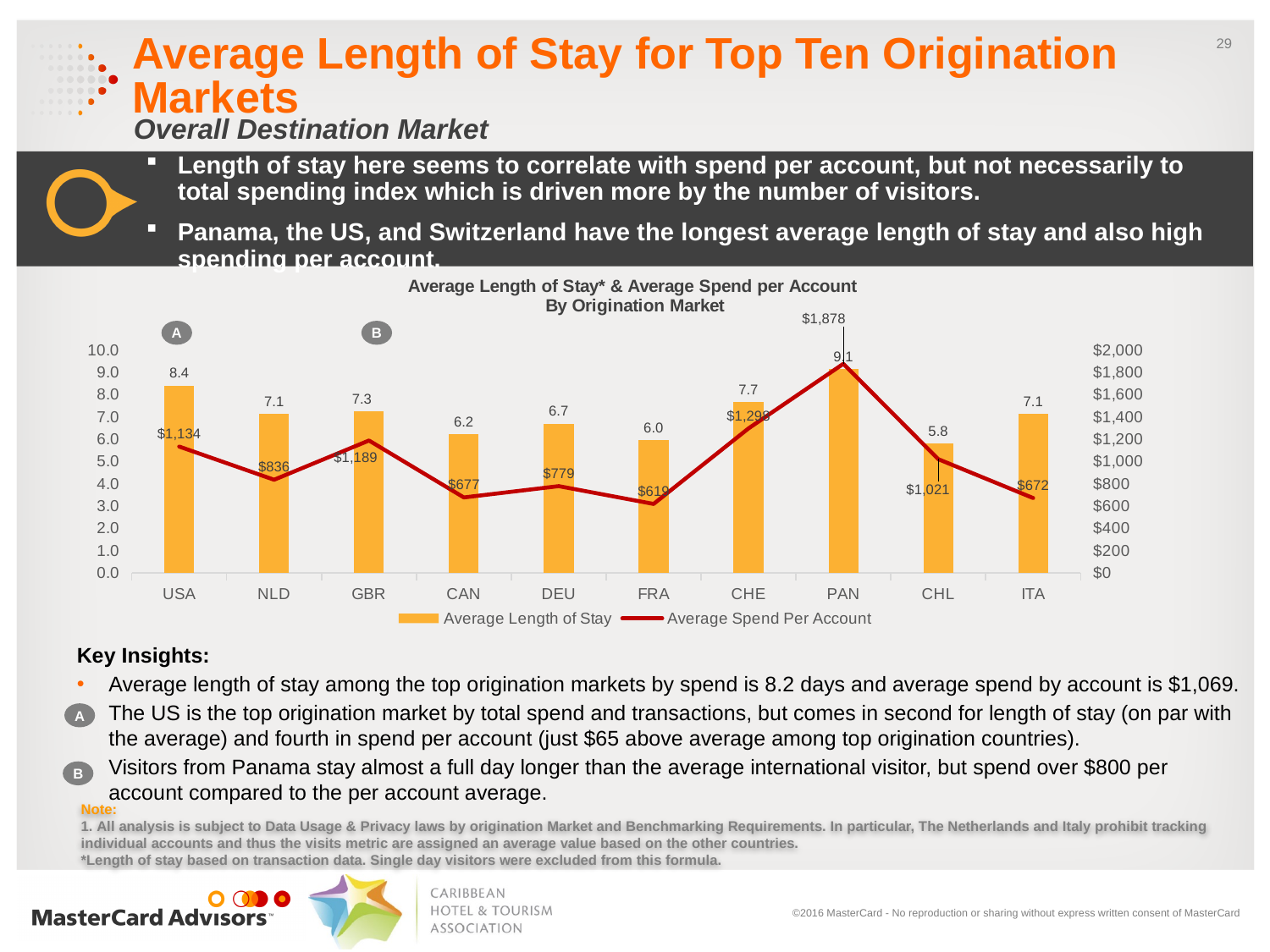
Which origination market has the lowest Average Spend Per Account? FRA What is the Average Spend Per Account for PAN? $1,878 What is the Average Length of Stay for USA? 8.4 How many origination markets are shown on the x axis? 10 Which origination market has the lowest Average Length of Stay? CHL What is the Average Spend Per Account for CHL? $1,021 What is the difference in Average Length of Stay between PAN and CHL? 3.3 Which origination market has the highest Average Length of Stay? PAN What kind of chart is this? Combination bar and line chart Which has a higher Average Length of Stay, GBR or CAN? GBR What is the difference in Average Spend Per Account between PAN and USA? $744 How many series does the legend list? 2